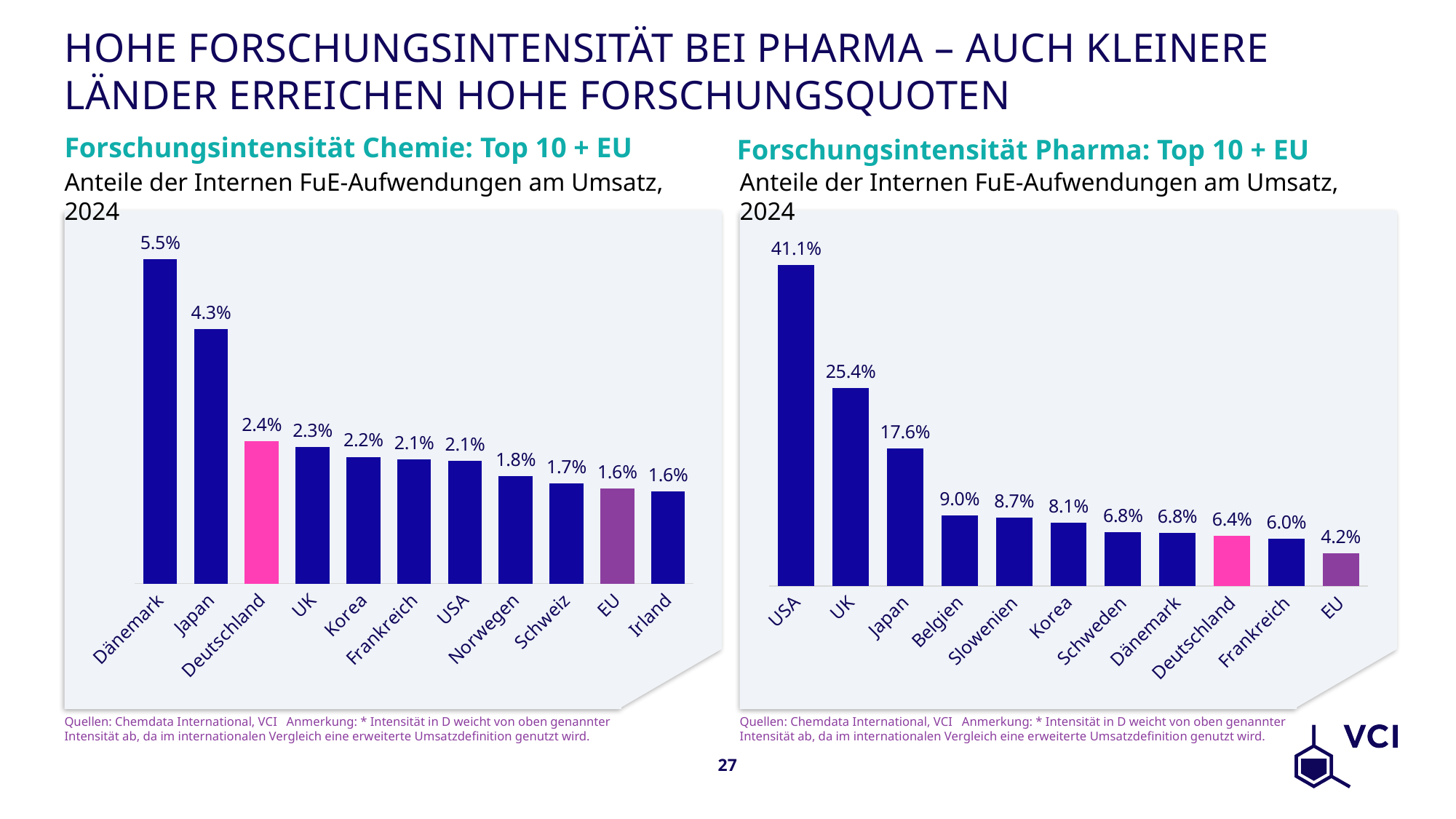
In the 'Forschungsintensität Chemie: Top 10 + EU' chart, what is the value for Dänemark? 5.5% In the 'Forschungsintensität Pharma: Top 10 + EU' chart, do the values rise or fall from left to right? Fall In the 'Forschungsintensität Chemie: Top 10 + EU' chart, which bar is coloured pink? Deutschland In the 'Forschungsintensität Pharma: Top 10 + EU' chart, what is the value for Deutschland? 6.4% How many categories are shown in the 'Forschungsintensität Pharma: Top 10 + EU' chart? 11 In the 'Forschungsintensität Pharma: Top 10 + EU' chart, which is larger, the value for Belgien or the value for Frankreich? Belgien In the 'Forschungsintensität Chemie: Top 10 + EU' chart, which is larger, the value for Korea or the value for Norwegen? Korea In the 'Forschungsintensität Chemie: Top 10 + EU' chart, which category has the lowest value? EU and Irland (both 1.6%) In the 'Forschungsintensität Pharma: Top 10 + EU' chart, what is the difference between the values for USA and UK? 15.7 percentage points What kind of chart is the 'Forschungsintensität Chemie: Top 10 + EU' chart? Bar chart In the 'Forschungsintensität Chemie: Top 10 + EU' chart, what is the difference between the values for Japan and Deutschland? 1.9 percentage points In the 'Forschungsintensität Pharma: Top 10 + EU' chart, which country has the highest value? USA